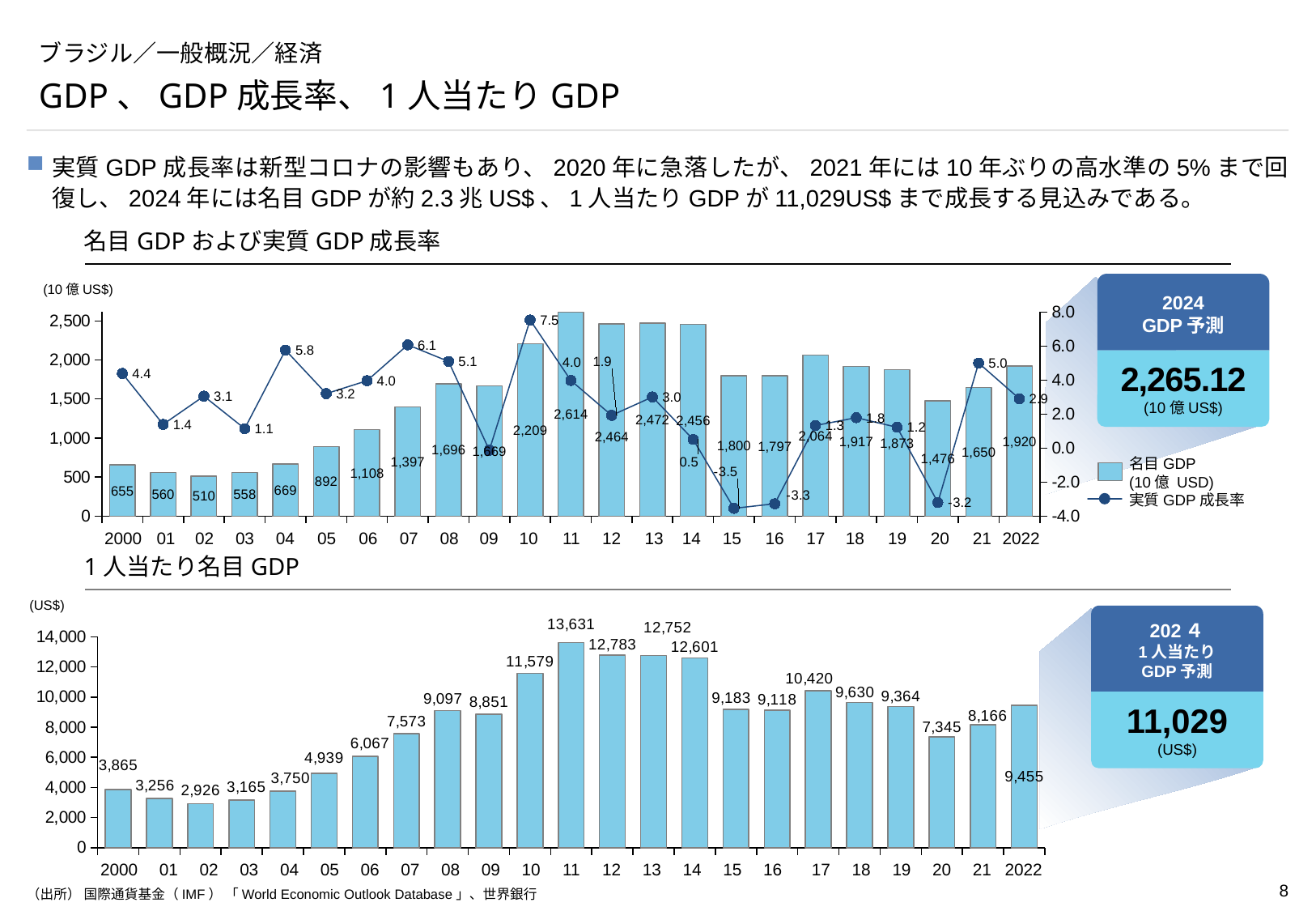
In the top chart (名目 GDP および実質 GDP 成長率), what is the nominal GDP value for 2011? 2,614 In the top chart (名目 GDP および実質 GDP 成長率), how many series does the legend list? 2 In the bottom chart (1 人当たり名目 GDP), which year has the highest value? 11 In the top chart (名目 GDP および実質 GDP 成長率), which year has the lowest real GDP growth rate? 15 What kind of chart is the bottom chart (1 人当たり名目 GDP)? Bar chart In the bottom chart (1 人当たり名目 GDP), which year has the lowest value? 02 In the top chart (名目 GDP および実質 GDP 成長率), what is the real GDP growth rate for 2010? 7.5 In the top chart (名目 GDP および実質 GDP 成長率), what is the difference between the nominal GDP of 2022 and 21? 270 In the bottom chart (1 人当たり名目 GDP), how many years are plotted on the x axis? 23 In the bottom chart (1 人当たり名目 GDP), what is the value for 2022? 9,455 In the bottom chart (1 人当たり名目 GDP), which is larger, the value for 17 or the value for 18? 17 In the top chart (名目 GDP および実質 GDP 成長率), which year has the lowest nominal GDP? 02